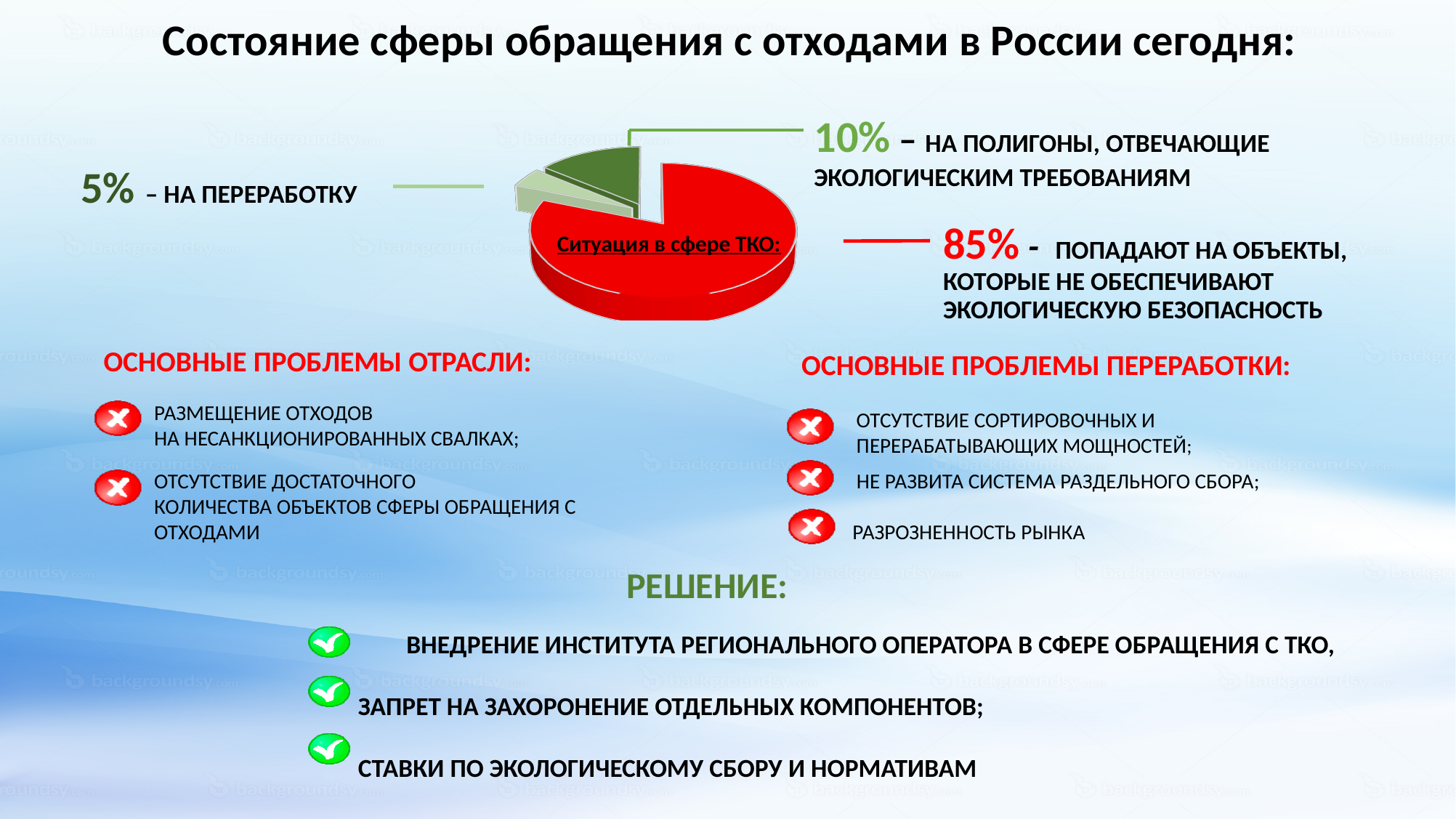
What share of the pie goes to "на полигоны, отвечающие экологическим требованиям"? 10% What colour is the largest slice of the pie chart? Red What is the title printed on the pie chart? Ситуация в сфере ТКО: What kind of chart is shown on the slide? Pie chart Which slice of the pie chart is the smallest? На переработку (5%) Which slice of the pie chart is the largest? Попадают на объекты, которые не обеспечивают экологическую безопасность (85%) How many slices does the pie chart have? 3 What is the difference between the share going to landfills meeting ecological requirements and the share going to recycling? 5% What share of the pie goes to "на переработку"? 5% Which is larger: the share going to recycling or the share going to landfills meeting ecological requirements? Landfills meeting ecological requirements (10%) What share of the pie goes to "попадают на объекты, которые не обеспечивают экологическую безопасность"? 85% What is the difference between the 85% slice and the 10% slice? 75%